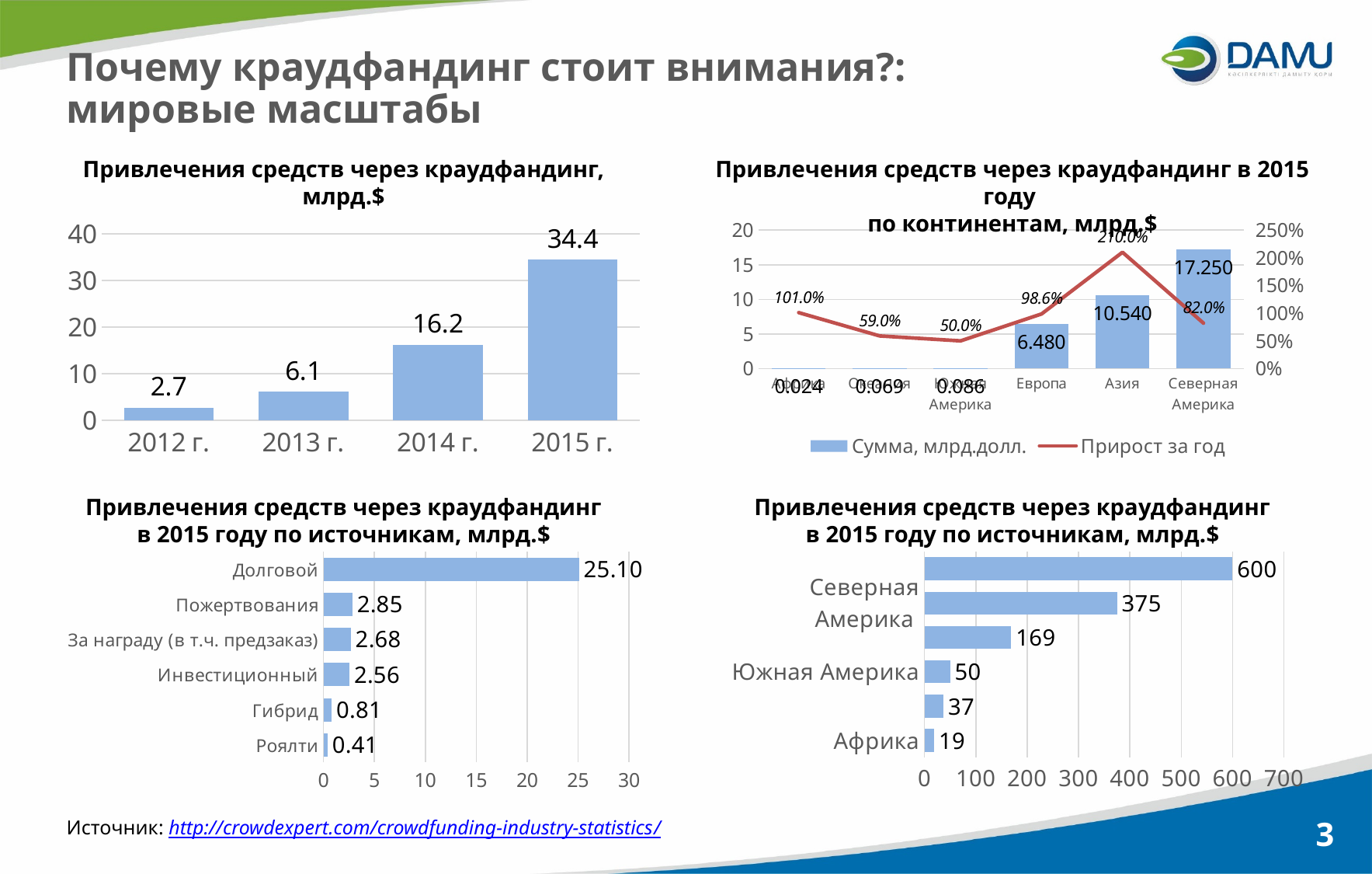
In the top-right chart 'Привлечения средств через краудфандинг в 2015 году по континентам, млрд.$', what is the 'Прирост за год' value for Европа? 98.6% In the bottom-left chart 'Привлечения средств через краудфандинг в 2015 году по источникам, млрд.$', what is the value for Долговой? 25.10 In the top-left chart 'Привлечения средств через краудфандинг, млрд.$', what is the value for 2015 г.? 34.4 In the top-right chart 'Привлечения средств через краудфандинг в 2015 году по континентам, млрд.$', what is the bar value for Азия? 10.540 In the top-left chart 'Привлечения средств через краудфандинг, млрд.$', what is the difference between the values for 2014 г. and 2013 г.? 10.1 In the top-right chart 'Привлечения средств через краудфандинг в 2015 году по континентам, млрд.$', which continent has the highest bar value? Северная Америка In the top-left chart 'Привлечения средств через краудфандинг, млрд.$', how many years are shown? 4 What kind of chart is the bottom-right chart on the slide? bar chart In the top-left chart 'Привлечения средств через краудфандинг, млрд.$', do the values rise or fall from 2012 г. to 2015 г.? rise In the top-right chart 'Привлечения средств через краудфандинг в 2015 году по континентам, млрд.$', how many series does the legend list? 2 In the bottom-left chart 'Привлечения средств через краудфандинг в 2015 году по источникам, млрд.$', which is larger: Пожертвования or Инвестиционный? Пожертвования In the bottom-left chart 'Привлечения средств через краудфандинг в 2015 году по источникам, млрд.$', which source has the lowest value? Роялти